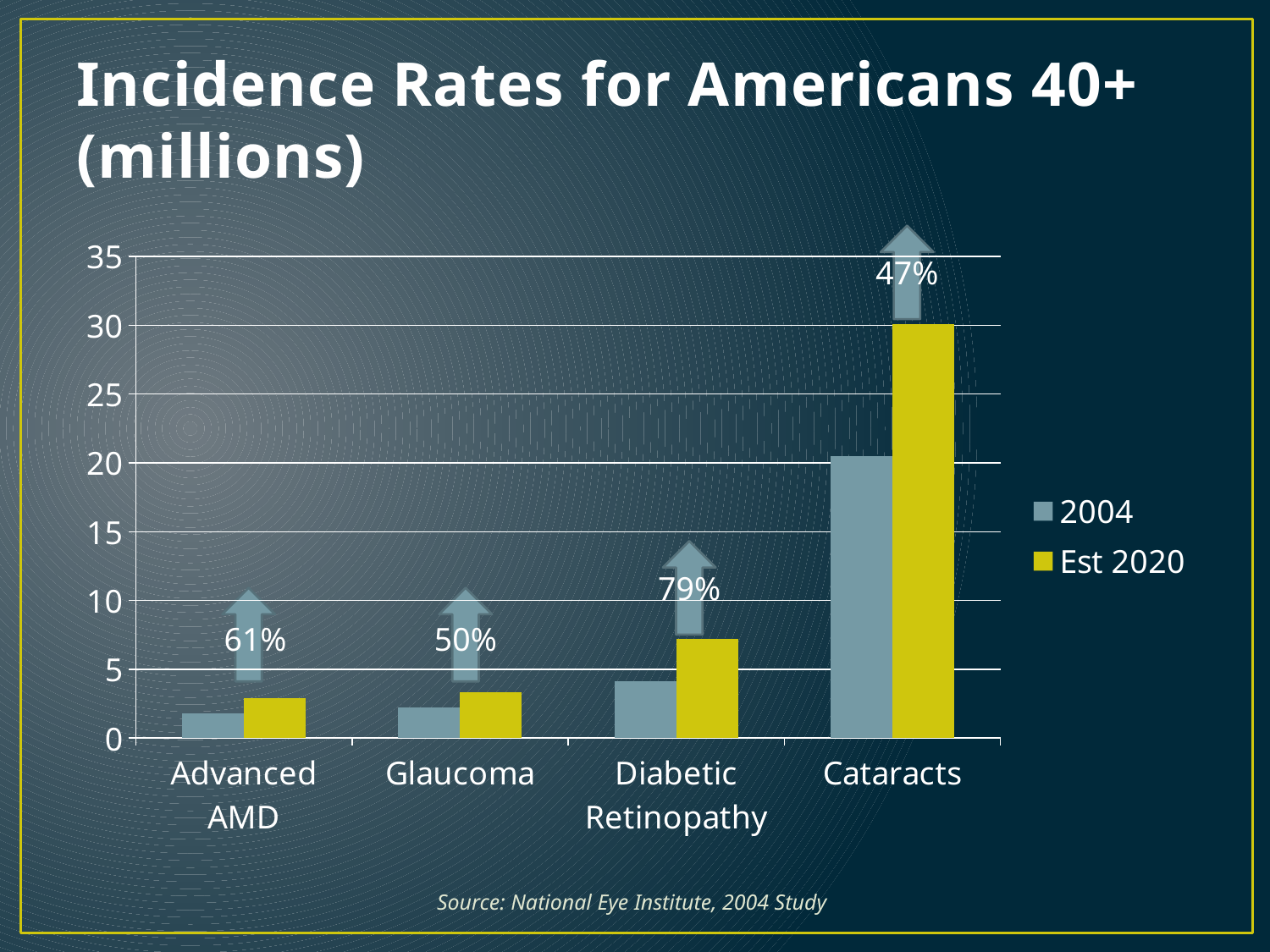
How many series does the chart's legend list? 2 Which is larger for Diabetic Retinopathy, the 2004 value or the Est 2020 value? Est 2020 Is the Est 2020 value for Glaucoma greater or less than 5? less What is the title of the chart on the slide? Incidence Rates for Americans 40+ (millions) How many categories are shown on the x axis of the chart? 4 What kind of chart is shown on the slide? bar chart Which category has the highest Est 2020 value? Cataracts Which is larger, the Est 2020 value for Glaucoma or the Est 2020 value for Diabetic Retinopathy? Diabetic Retinopathy Is the Est 2020 value for Diabetic Retinopathy greater or less than 10? less What percentage increase is annotated above the Cataracts bars? 47% Which category has the lowest 2004 value? Advanced AMD